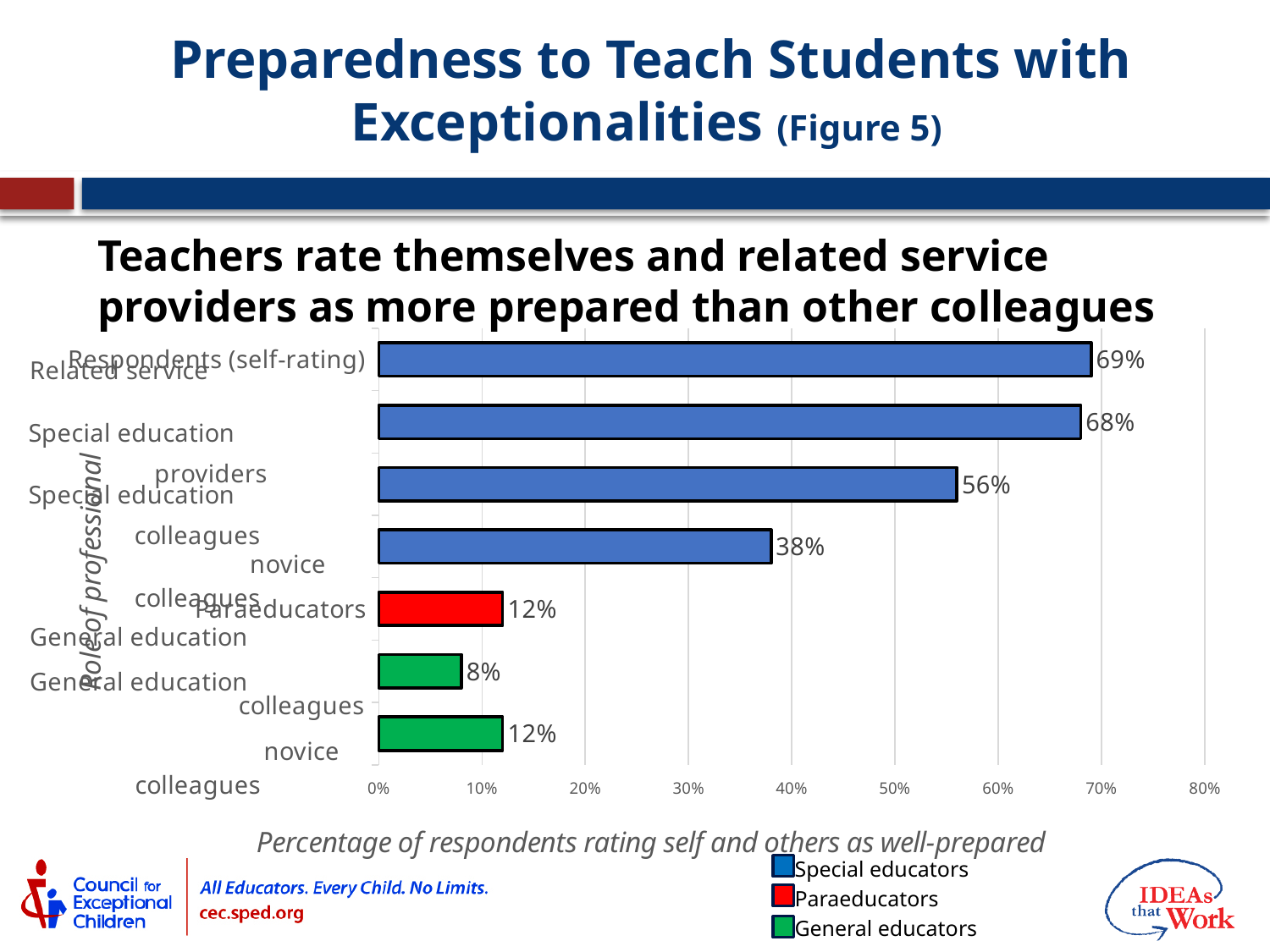
What is the maximum value shown on the x axis? 80% What percentage of respondents rated themselves (self-rating) as well-prepared? 69% What percentage of respondents rated paraeducators as well-prepared? 12% What kind of chart is shown on the slide? Bar chart How many series does the legend list? 3 What is the value of the second bar from the top? 68% How many bars are plotted in the chart? 7 Which is larger: the self-rating value or the paraeducators value? Self-rating What is the value of the lowest bar in the chart? 8% Which category has the highest value in the chart? Respondents (self-rating) What is the difference between the self-rating value (69%) and the paraeducators value (12%)? 57% What colour are the bars for the Paraeducators series? Red